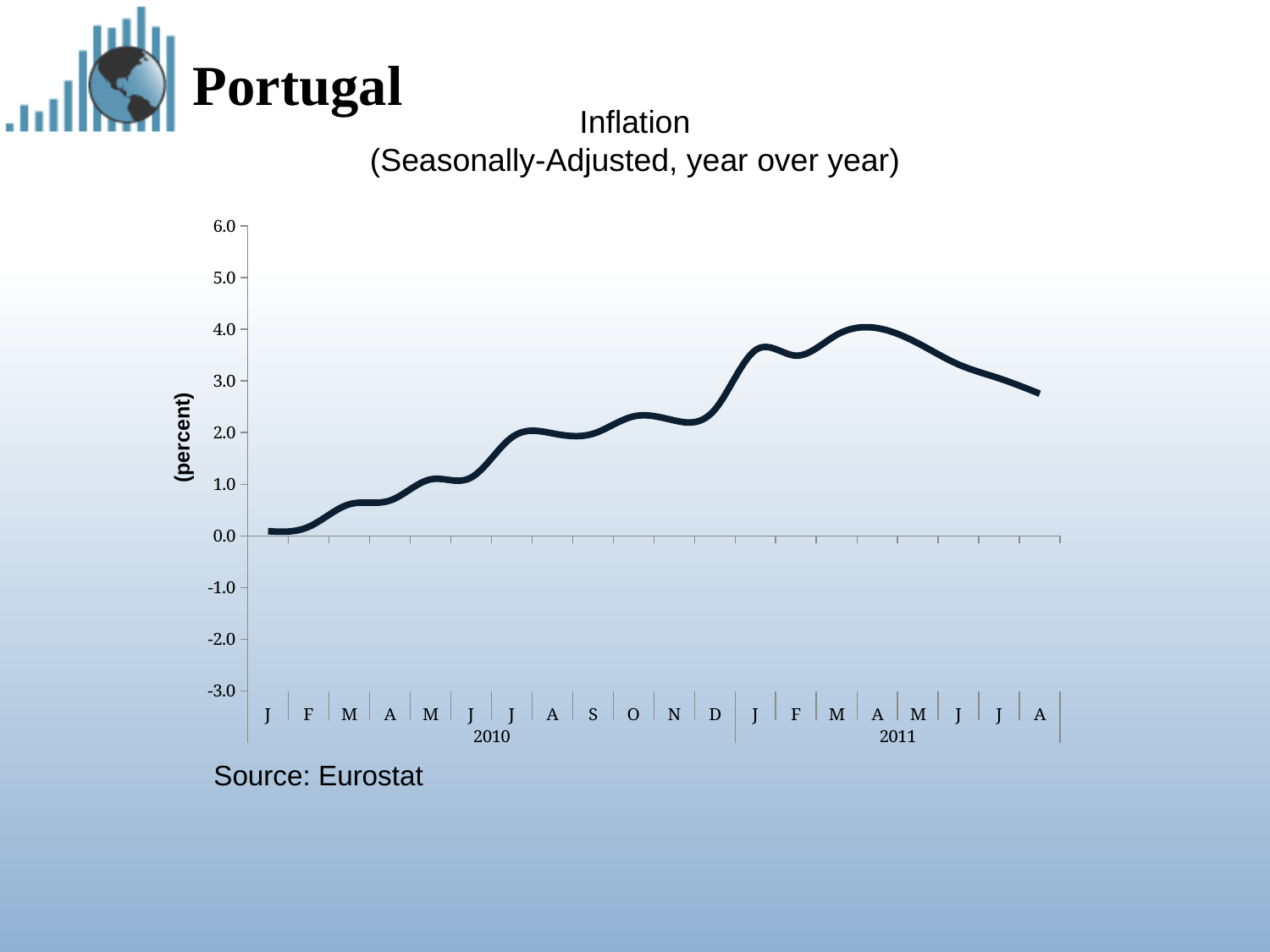
Is the inflation value for August 2011 greater or less than 3.0? less Does the inflation line generally rise or fall from January 2010 to April 2011? rise How many monthly data points are plotted on the chart? 20 What is the label on the vertical axis of the chart? (percent) In which month is the inflation value lowest? January 2010 Is the inflation value for October 2010 greater or less than 2.0? greater Does the inflation line rise or fall from April 2011 to August 2011? fall Is the inflation value for March 2010 greater or less than 1.0? less What kind of chart is shown on the slide? line chart Which month has a higher inflation value, January 2010 or January 2011? January 2011 In which month does the inflation line reach its highest value? April 2011